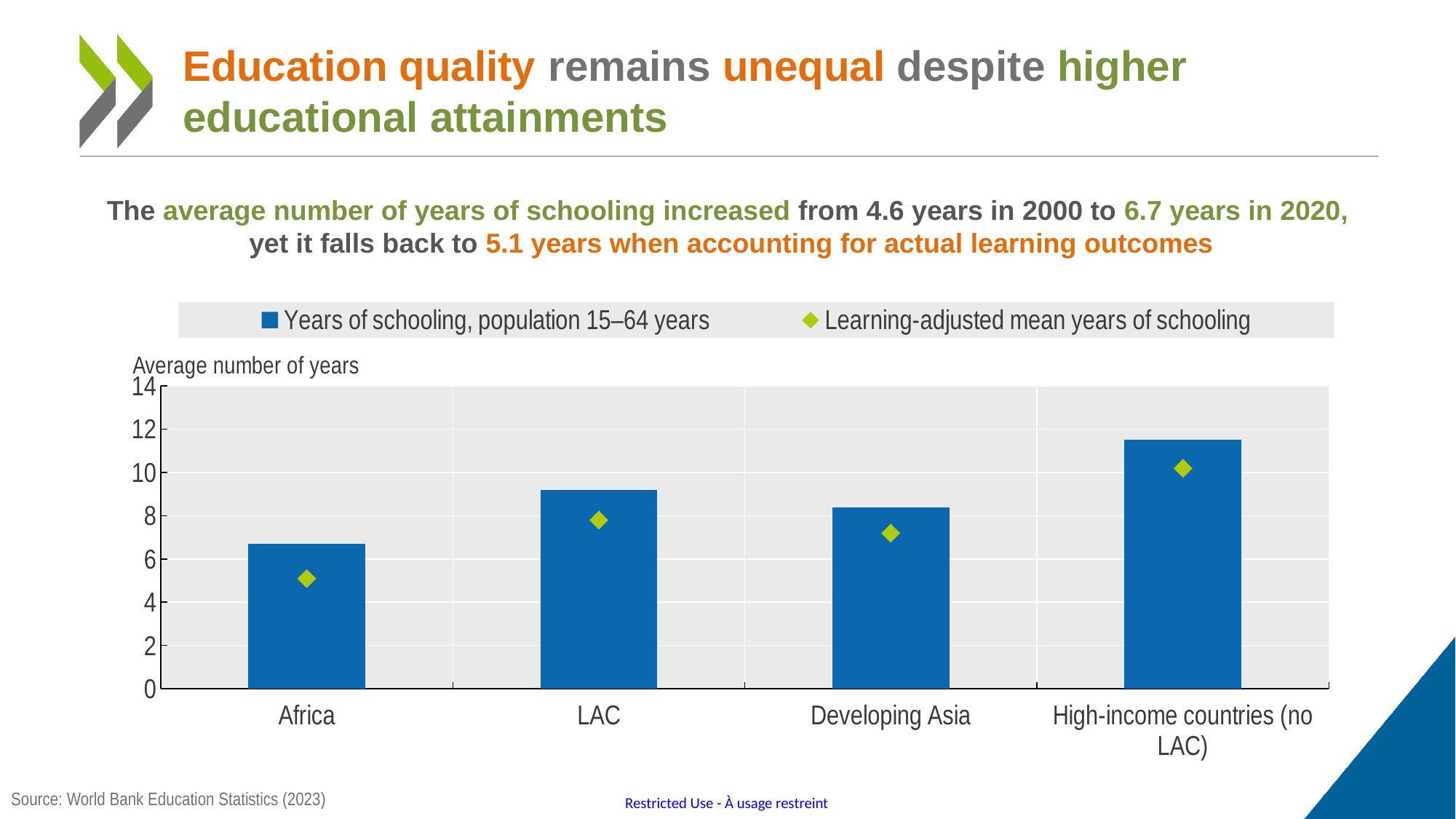
Which category has the lowest bar for years of schooling, population 15–64 years? Africa How many series does the chart legend list? 2 Is the years of schooling bar for LAC higher or lower than the bar for Developing Asia? higher Is the learning-adjusted mean years of schooling for Africa greater or less than 6? less How many categories are shown on the x axis of the chart? 4 What is the label of the vertical axis of the chart? Average number of years Which category has the lowest learning-adjusted mean years of schooling? Africa Which category has the highest bar for years of schooling, population 15–64 years? High-income countries (no LAC) Is the years of schooling value for High-income countries (no LAC) greater or less than 10? greater Which series is represented by the green diamond markers in the chart? Learning-adjusted mean years of schooling Is the years of schooling value for LAC greater or less than 8? greater What kind of chart is shown on the slide? Bar chart with markers